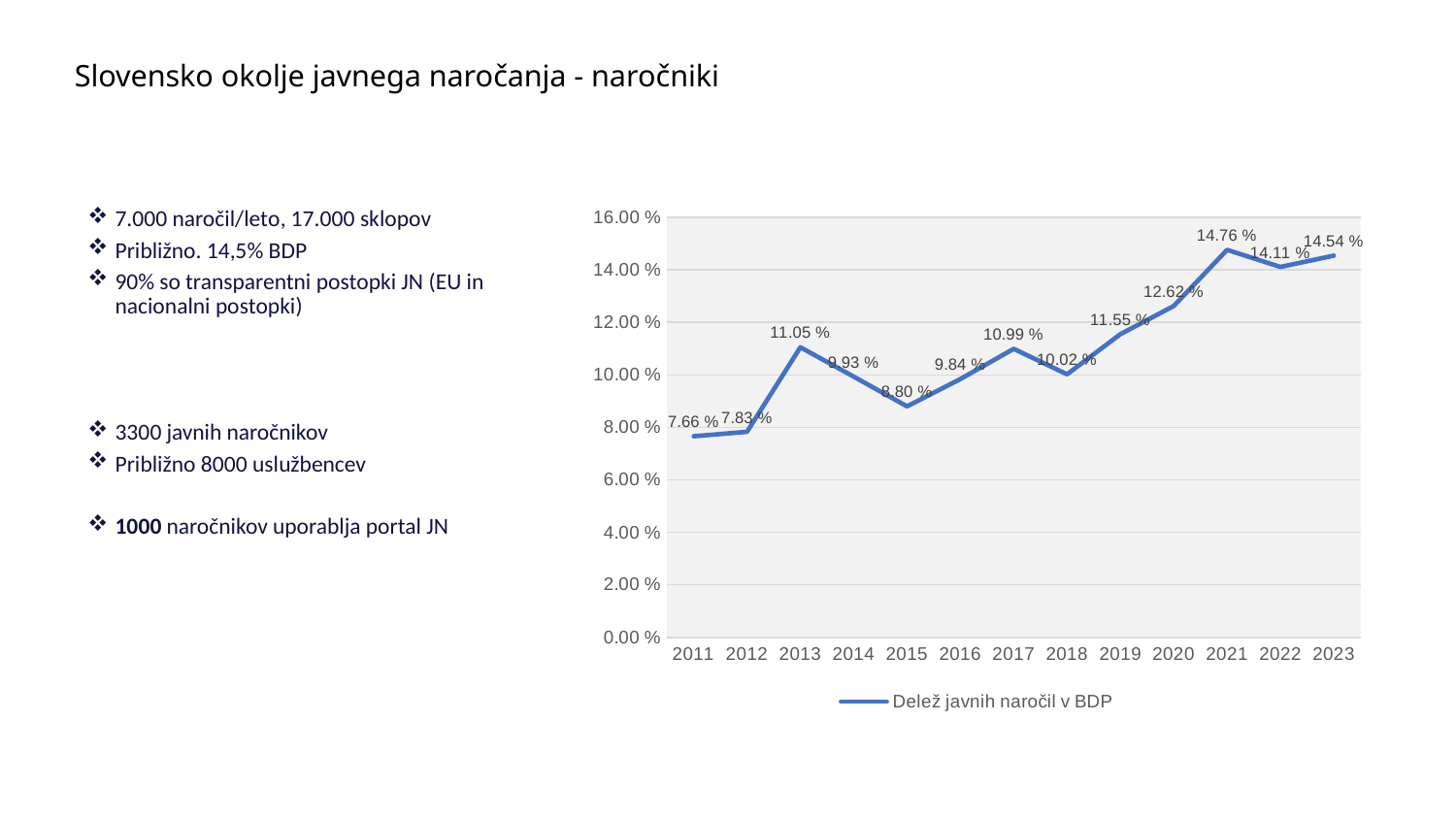
How many series does the chart legend list? 1 What is the difference between the values for 2023 and 2022? 0.43 % What is the value for 2021 in the chart? 14.76 % What kind of chart is shown on the slide? line chart What is the value for 2013 in the chart? 11.05 % Which year has the highest value in the chart? 2021 Which year has the lowest value in the chart? 2011 Is the value for 2020 greater or less than 12.00 %? greater What is the name of the series shown in the chart legend? Delež javnih naročil v BDP What is the value for 2011 in the chart? 7.66 % Which is larger, the value for 2015 or the value for 2016? 2016 How many years are plotted on the x axis of the chart? 13